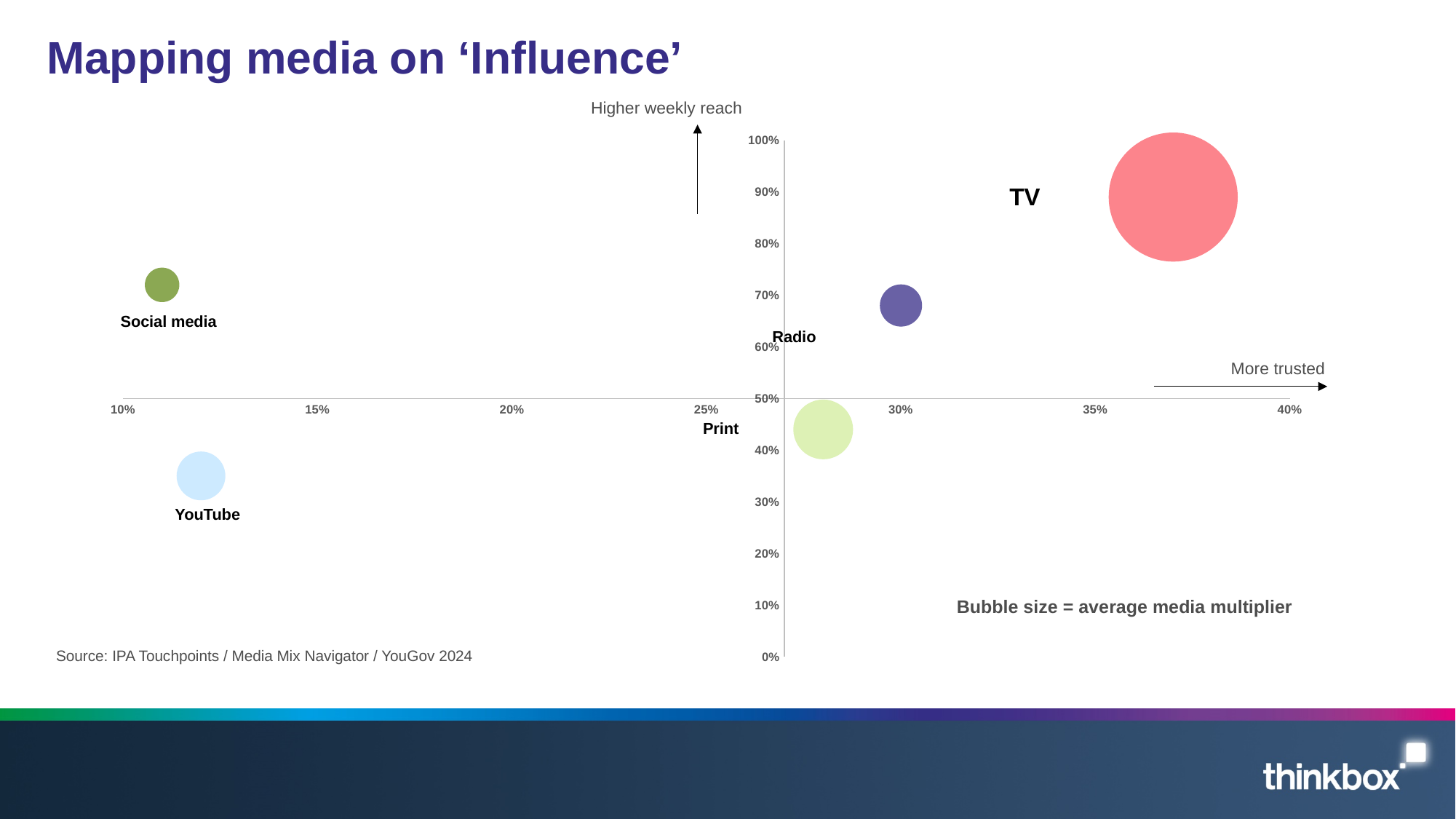
Which is plotted as more trusted, Radio or Social media? Radio How many media bubbles are plotted on the chart? 5 Which medium is plotted as the most trusted (furthest right)? TV Is the trust value for Social media greater or less than 15%? less Which medium has the lowest weekly reach on the chart? YouTube Which medium has the largest bubble on the chart? TV Which has the higher weekly reach, Radio or Print? Radio Is the weekly reach for YouTube greater or less than 40%? less What kind of chart is shown on the slide? Bubble chart According to the slide, what does the bubble size represent? Average media multiplier Is the weekly reach for TV greater or less than 80%? greater Which medium has the highest weekly reach on the chart? TV